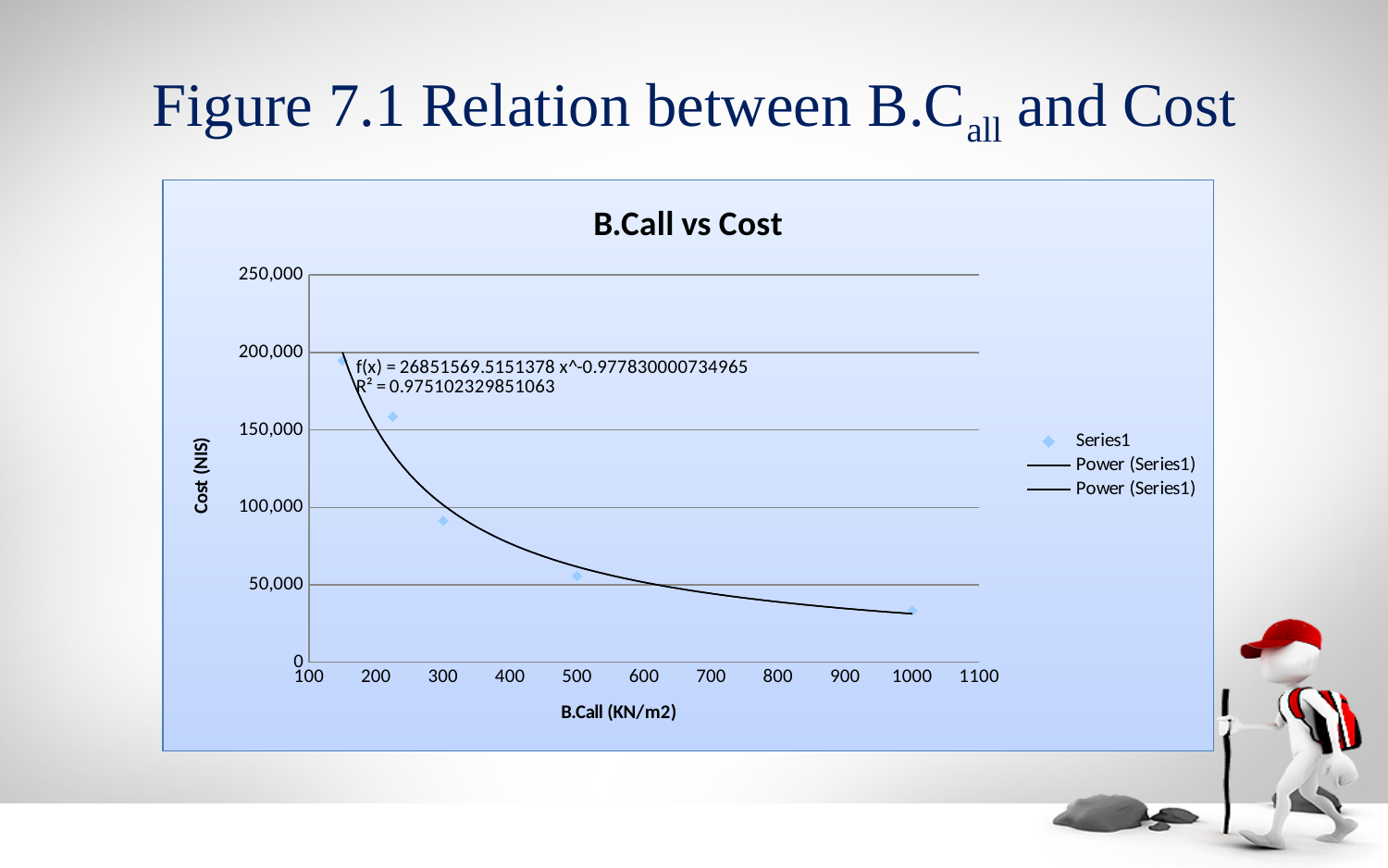
How many entries does the chart legend list? 3 Is the cost for the point at B.Call 1000 greater or less than 50,000? less What kind of chart is shown on the slide? scatter chart Does the cost rise or fall as B.Call increases along the x axis? fall What is the title of the chart? B.Call vs Cost How many data points are plotted in the chart? 5 Is the cost for the leftmost data point greater or less than 150,000? greater Is the cost for the point at B.Call 300 greater or less than 100,000? less What is the label of the y axis? Cost (NIS) What R² value is printed on the chart? 0.975102329851063 Which data point has the lowest cost, the leftmost or the rightmost? the rightmost Which has the higher cost, the point at B.Call 300 or the point at B.Call 500? the point at B.Call 300